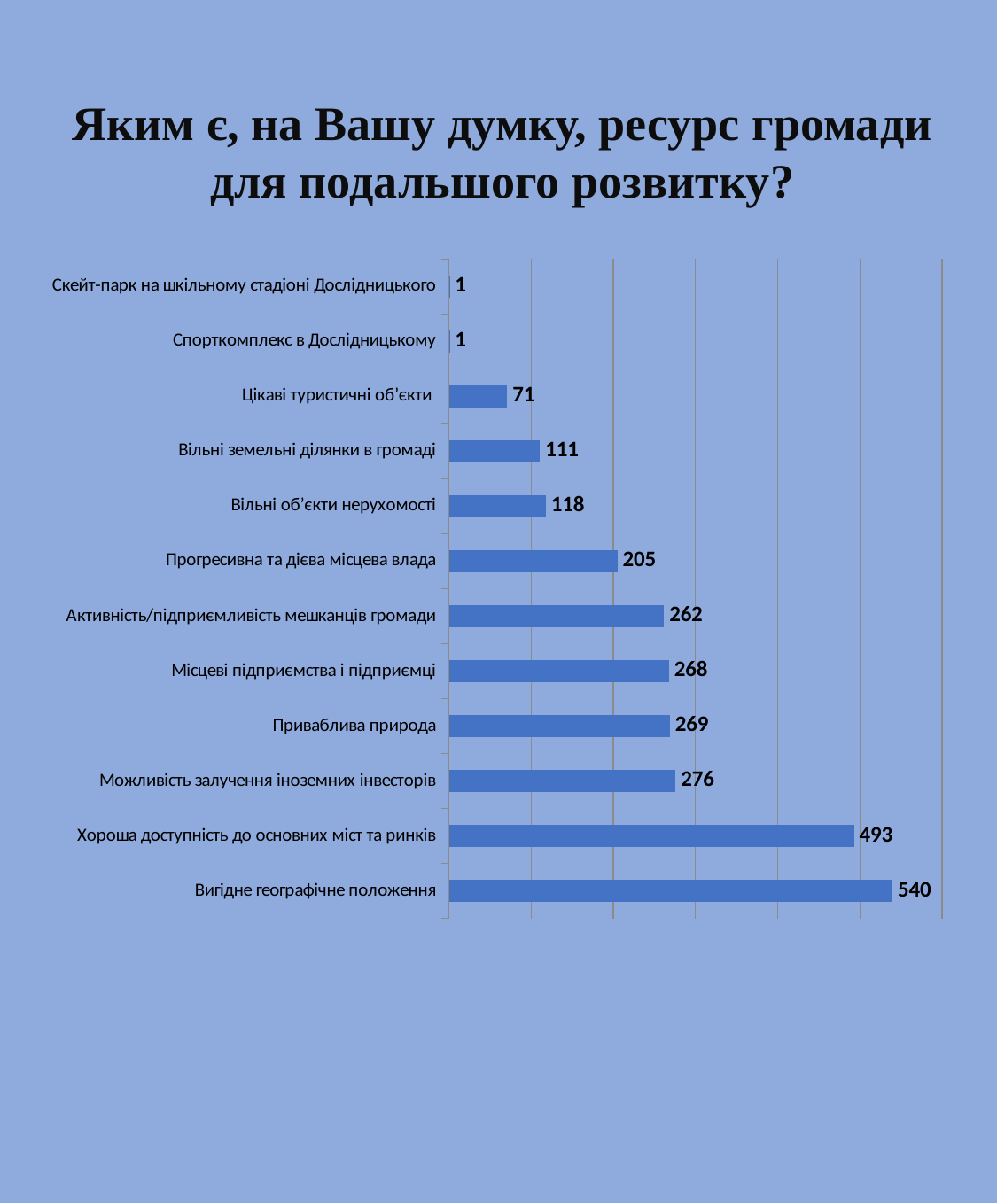
Which category has the highest value? Вигідне географічне положення Which is larger: the value for "Прогресивна та дієва місцева влада" or the value for "Вільні об’єкти нерухомості"? Прогресивна та дієва місцева влада What is the difference between the values for "Вигідне географічне положення" and "Хороша доступність до основних міст та ринків"? 47 What value is shown for "Вигідне географічне положення"? 540 What value is shown for "Прогресивна та дієва місцева влада"? 205 Which is larger: the value for "Можливість залучення іноземних інвесторів" or the value for "Активність/підприємливість мешканців громади"? Можливість залучення іноземних інвесторів What is the title of the chart? Яким є, на Вашу думку, ресурс громади для подальшого розвитку? How many categories are shown in the chart? 12 What value is shown for "Цікаві туристичні об’єкти"? 71 What value is shown for "Спорткомплекс в Дослідницькому"? 1 What kind of chart is shown on the slide? Bar chart What is the difference between the values for "Вільні об’єкти нерухомості" and "Вільні земельні ділянки в громаді"? 7